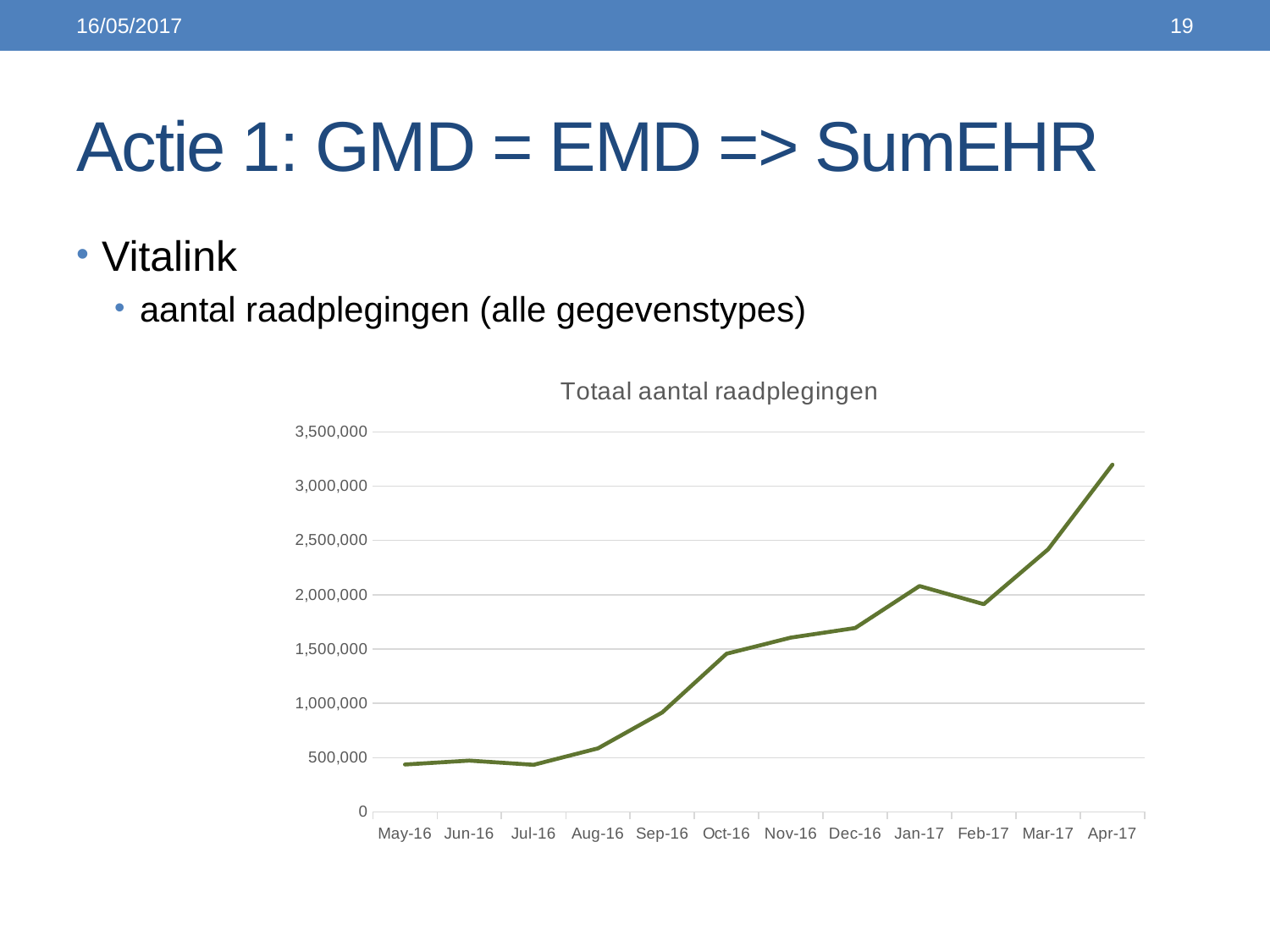
What is the title of the chart? Totaal aantal raadplegingen Is the value for Oct-16 greater or less than 1,000,000? greater Is the value for May-16 greater or less than 500,000? less Which is larger, the value for Aug-16 or the value for Sep-16? Sep-16 Is the value for Sep-16 greater or less than 1,000,000? less Which is larger, the value for Jan-17 or the value for Feb-17? Jan-17 Do the values generally rise or fall from May-16 to Apr-17? rise What kind of chart is shown on the slide? line chart How many months are plotted on the x axis of the chart? 12 Which month has the highest value in the chart? Apr-17